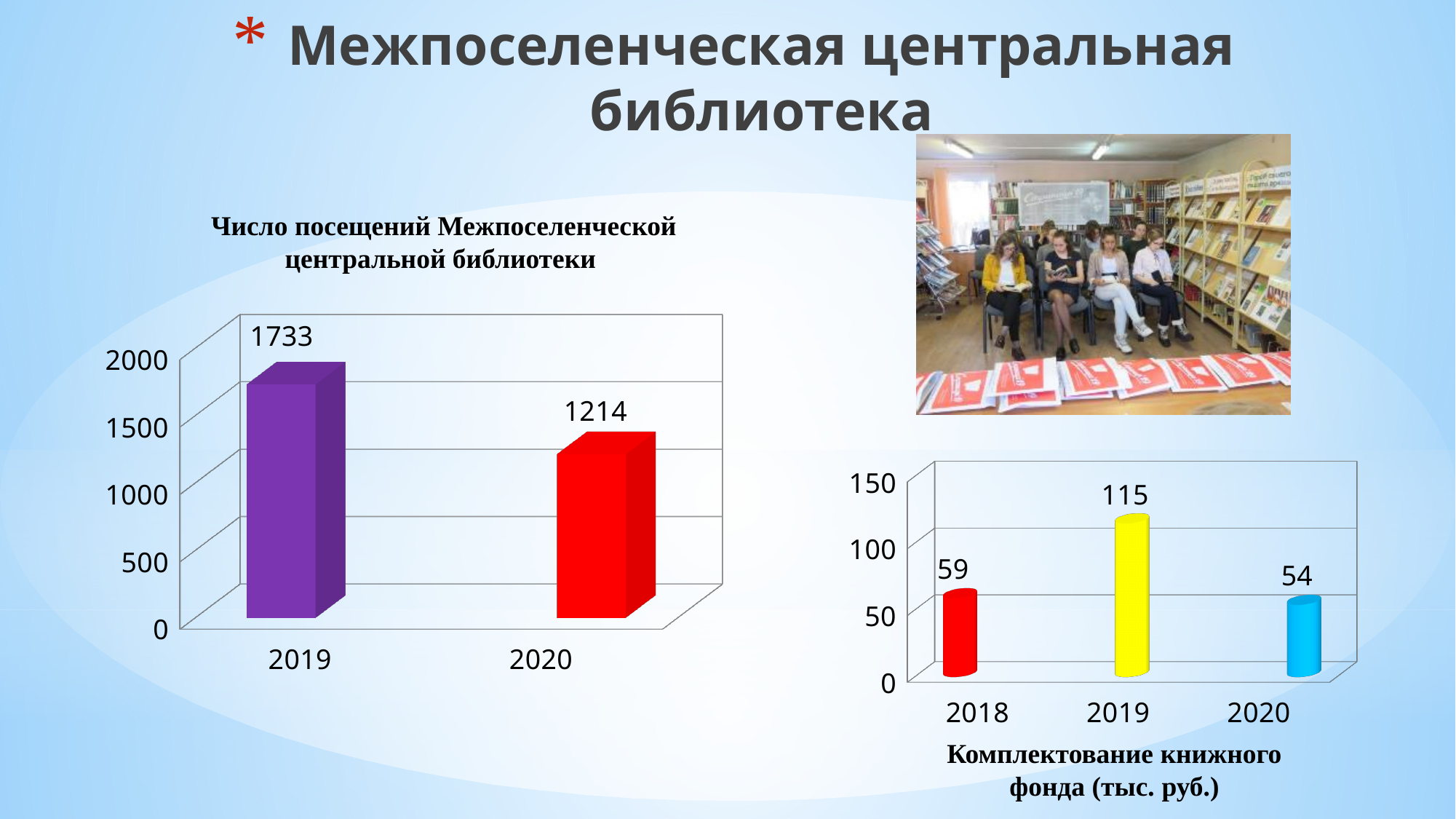
In the chart 'Число посещений Межпоселенческой центральной библиотеки', how many categories are shown on the x axis? 2 In the chart 'Комплектование книжного фонда (тыс. руб.)', how many categories are shown on the x axis? 3 In the chart 'Число посещений Межпоселенческой центральной библиотеки', what is the value for 2019? 1733 In the chart 'Комплектование книжного фонда (тыс. руб.)', which year has the lowest value? 2020 In the chart 'Число посещений Межпоселенческой центральной библиотеки', do the values rise or fall from 2019 to 2020? fall In the chart 'Комплектование книжного фонда (тыс. руб.)', which year has the highest value? 2019 In the chart 'Комплектование книжного фонда (тыс. руб.)', what is the value for 2018? 59 In the chart 'Число посещений Межпоселенческой центральной библиотеки', what is the difference between the 2019 and 2020 values? 519 What kind of chart is 'Комплектование книжного фонда (тыс. руб.)'? bar chart In the chart 'Число посещений Межпоселенческой центральной библиотеки', what is the value for 2020? 1214 In the chart 'Комплектование книжного фонда (тыс. руб.)', what is the difference between the 2019 and 2020 values? 61 In the chart 'Комплектование книжного фонда (тыс. руб.)', what is the value for 2019? 115